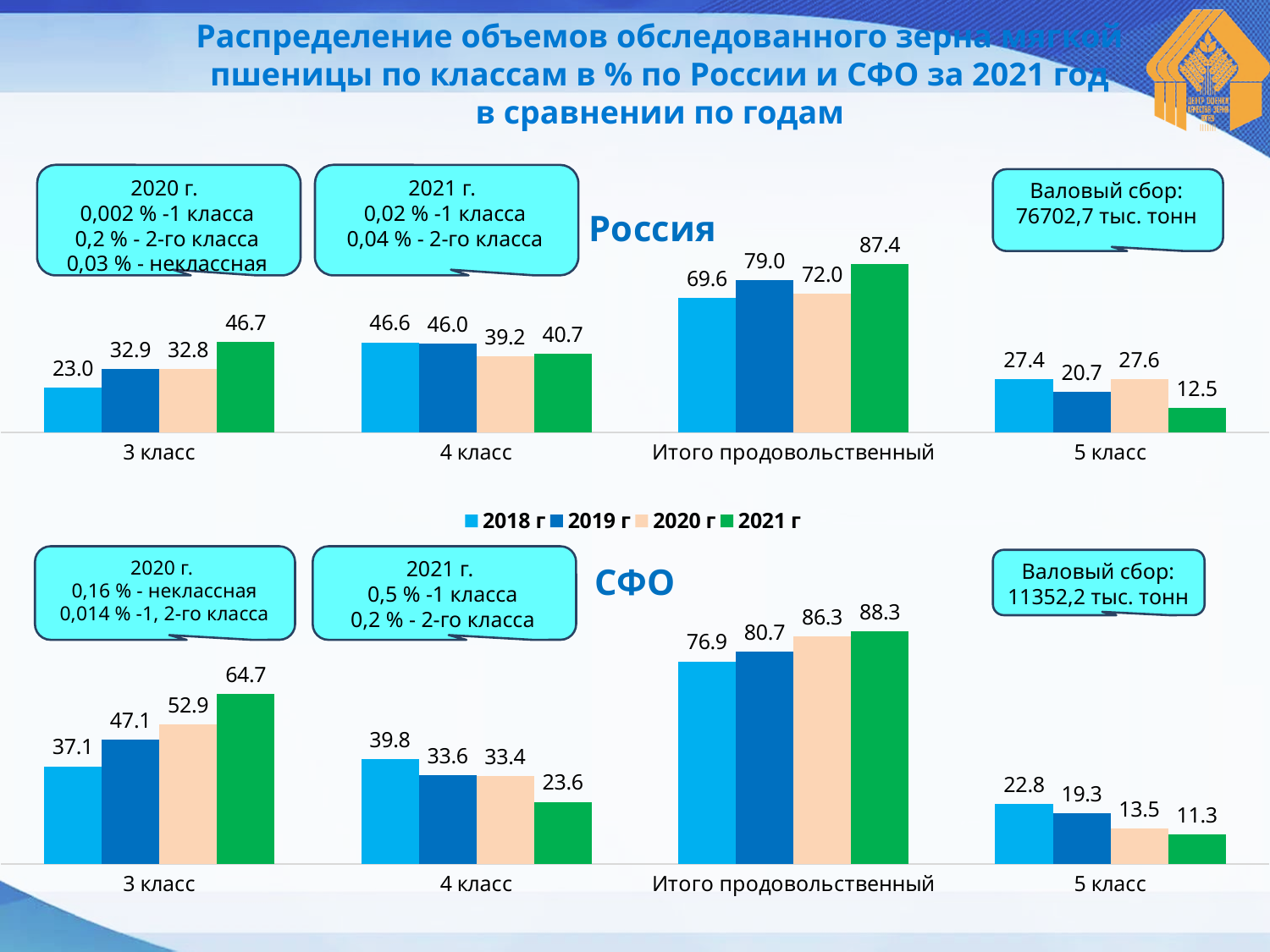
In the СФО chart, which is larger in the 5 класс category: the 2018 г value or the 2019 г value? 2018 г In the СФО chart, which year has the highest value in the 3 класс category? 2021 г In the Россия chart, which year has the lowest value in the 5 класс category? 2021 г How many series does the legend list? 4 In the СФО chart, what is the value for 2020 г in the 4 класс category? 33.4 In the Россия chart, what is the value for 2019 г in the Итого продовольственный category? 79.0 In the Россия chart, what is the value for 2021 г in the 3 класс category? 46.7 In the СФО chart, what is the difference between the 2018 г and 2021 г values in the 4 класс category? 16.2 In the Россия chart, what is the difference between the 2021 г and 2018 г values in the Итого продовольственный category? 17.8 What type of chart is the СФО chart? bar chart In the СФО chart, do the values in the Итого продовольственный category rise or fall from 2018 г to 2021 г? rise How many categories are shown on the x axis of the Россия chart? 4